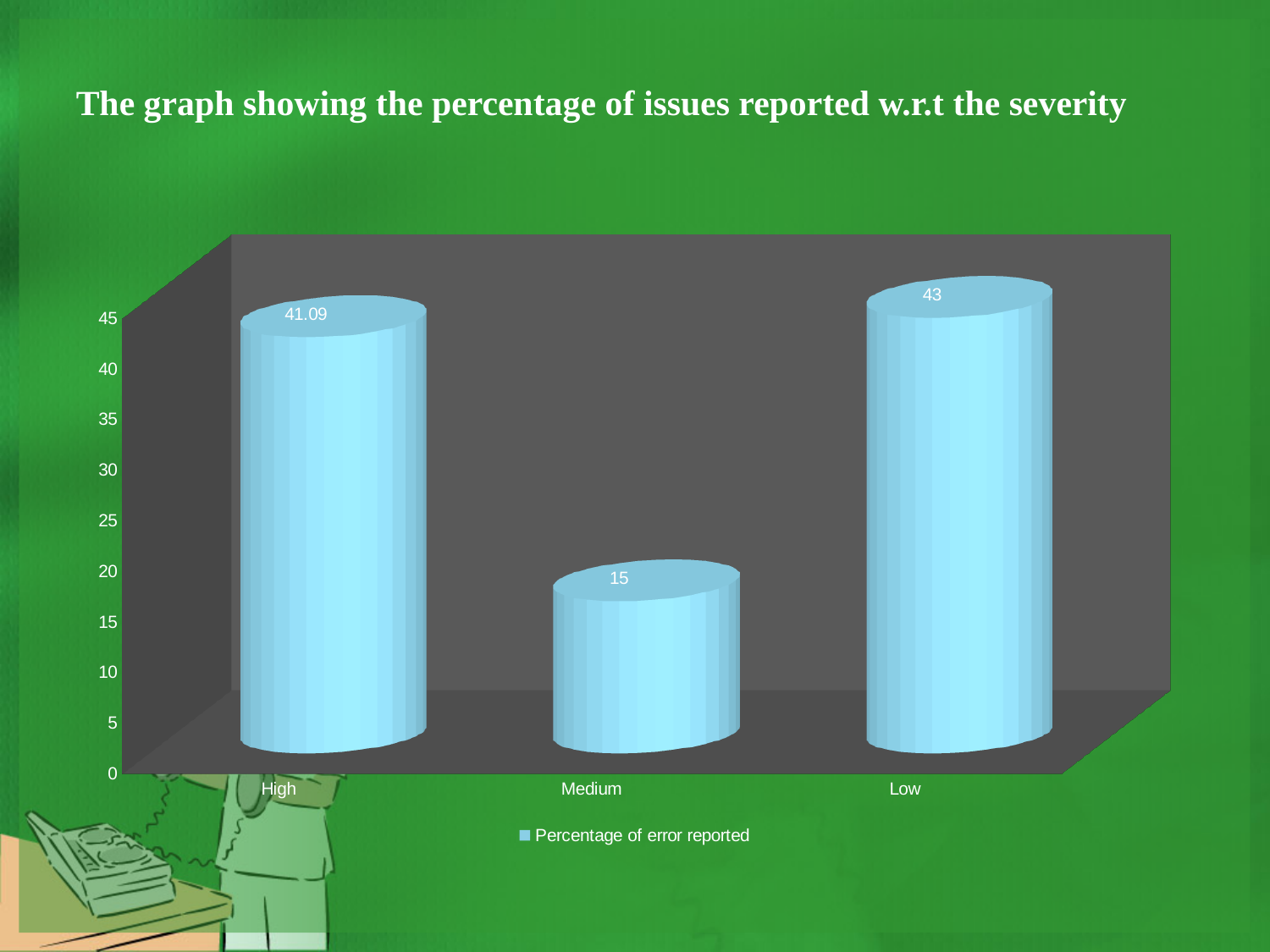
Which is larger, the value for High or the value for Medium? High What is the difference between the values for Low and High? 1.91 What is the value for High? 41.09 Which severity category has the highest percentage of error reported? Low Is the value for Medium greater or less than 20? less How many severity categories are shown on the x axis? 3 What is the value for Low? 43 Which severity category has the lowest percentage of error reported? Medium What is the difference between the values for Low and Medium? 28 What is the value for Medium? 15 How many series does the legend list? 1 What kind of chart is shown on the slide? bar chart